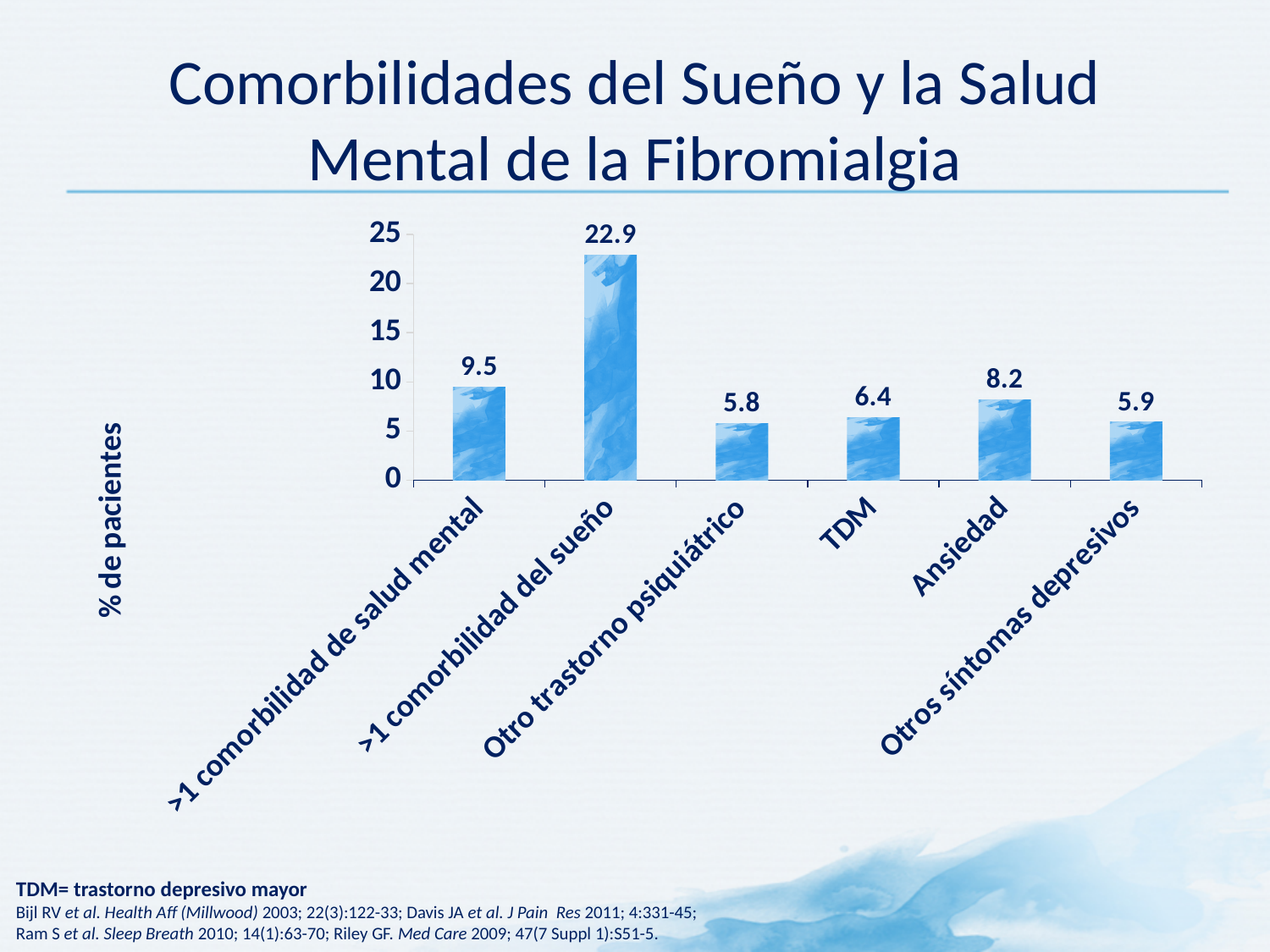
What is the value for 'TDM'? 6.4 What is the value for '>1 comorbilidad del sueño'? 22.9 Is the value for '>1 comorbilidad del sueño' greater or less than 20? greater Which is larger, the value for 'Ansiedad' or the value for 'TDM'? Ansiedad What is the value for 'Ansiedad'? 8.2 What kind of chart is shown on the slide? bar chart What is the label of the y axis? % de pacientes What is the difference between the values for '>1 comorbilidad del sueño' and '>1 comorbilidad de salud mental'? 13.4 How many categories are shown on the x axis? 6 Which category has the lowest value? Otro trastorno psiquiátrico What is the value for '>1 comorbilidad de salud mental'? 9.5 Which category has the highest value? >1 comorbilidad del sueño